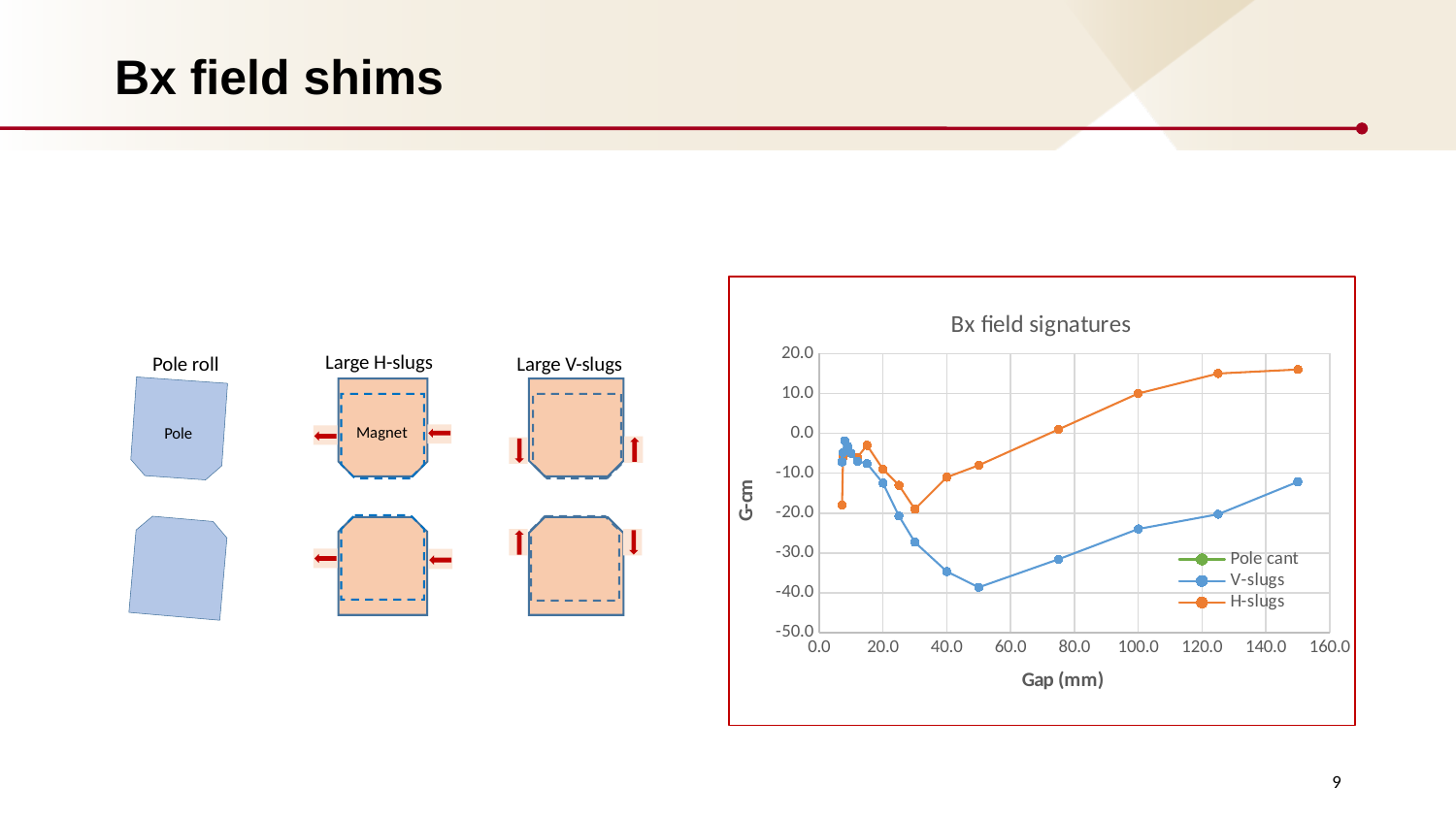
How many series does the legend of the 'Bx field signatures' chart list? 3 In the 'Bx field signatures' chart, is the V-slugs value at a gap of 50.0 mm greater or less than -30.0? less In the 'Bx field signatures' chart, does the H-slugs series rise or fall as the gap increases from 40.0 mm to 150.0 mm? rise What is the y-axis title of the 'Bx field signatures' chart? G-cm In the 'Bx field signatures' chart, which series has the larger value at a gap of 150.0 mm, H-slugs or V-slugs? H-slugs What kind of chart is the 'Bx field signatures' chart? line chart What is the x-axis title of the 'Bx field signatures' chart? Gap (mm) In the 'Bx field signatures' chart, is the H-slugs value at a gap of 40.0 mm greater or less than 0.0? less In the 'Bx field signatures' chart, is the V-slugs value at a gap of 150.0 mm greater or less than 0.0? less